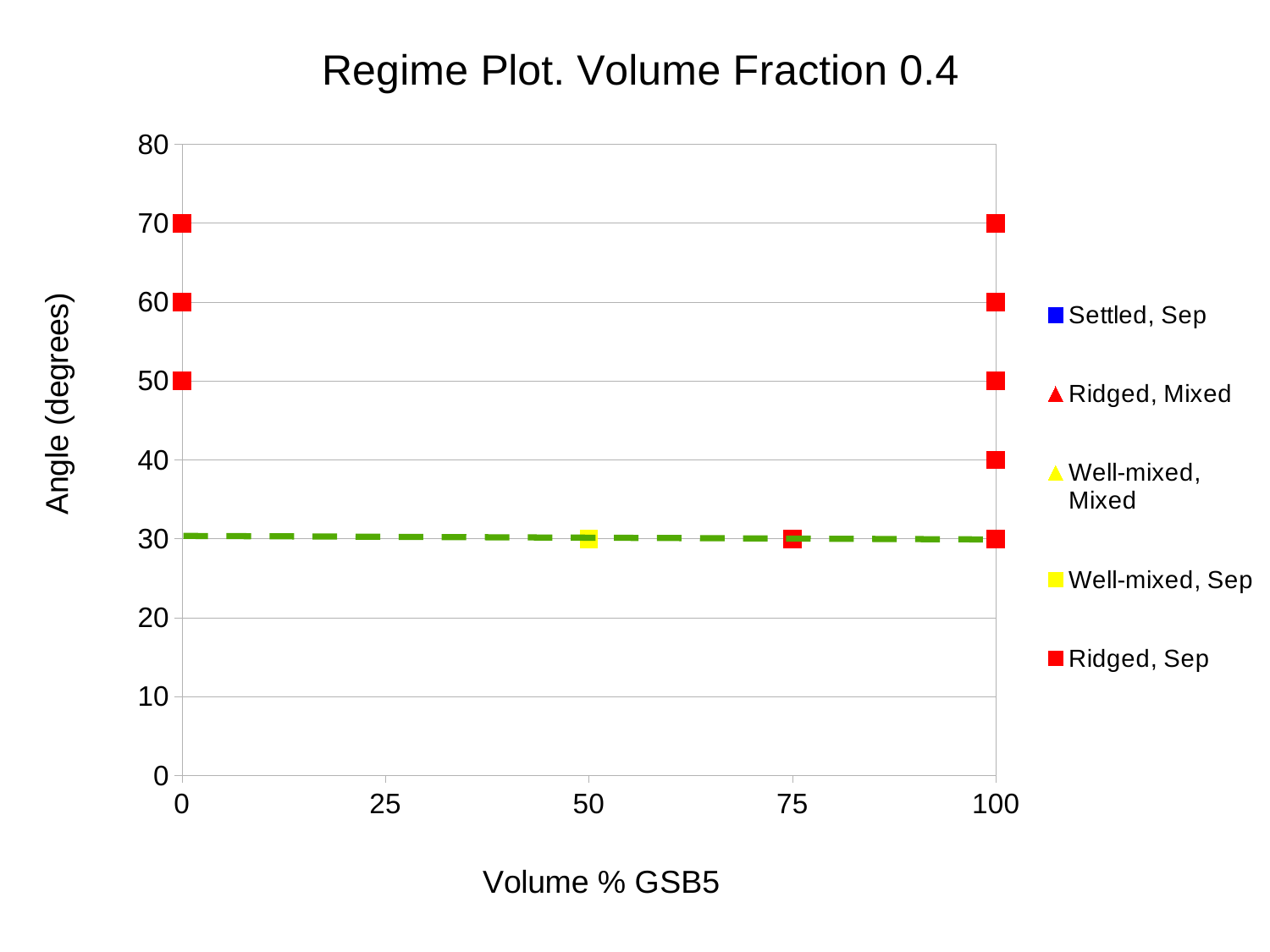
At what Volume % GSB5 is the Well-mixed, Sep point plotted? 50 At what angle is the Well-mixed, Sep point plotted? 30 How many series does the legend list? 5 What kind of chart is shown on the slide? Scatter chart How many Ridged, Sep points are plotted at 0 Volume % GSB5? 3 What is the title of the chart? Regime Plot. Volume Fraction 0.4 What is the highest angle at which a Ridged, Sep point appears at 100 Volume % GSB5? 70 Is the angle of the Well-mixed, Sep point greater or less than 40? less What is the label of the y axis? Angle (degrees) Which series has the most points plotted on the chart? Ridged, Sep What is the lowest angle at which a Ridged, Sep point appears at 0 Volume % GSB5? 50 How many Ridged, Sep points are plotted at 100 Volume % GSB5? 5